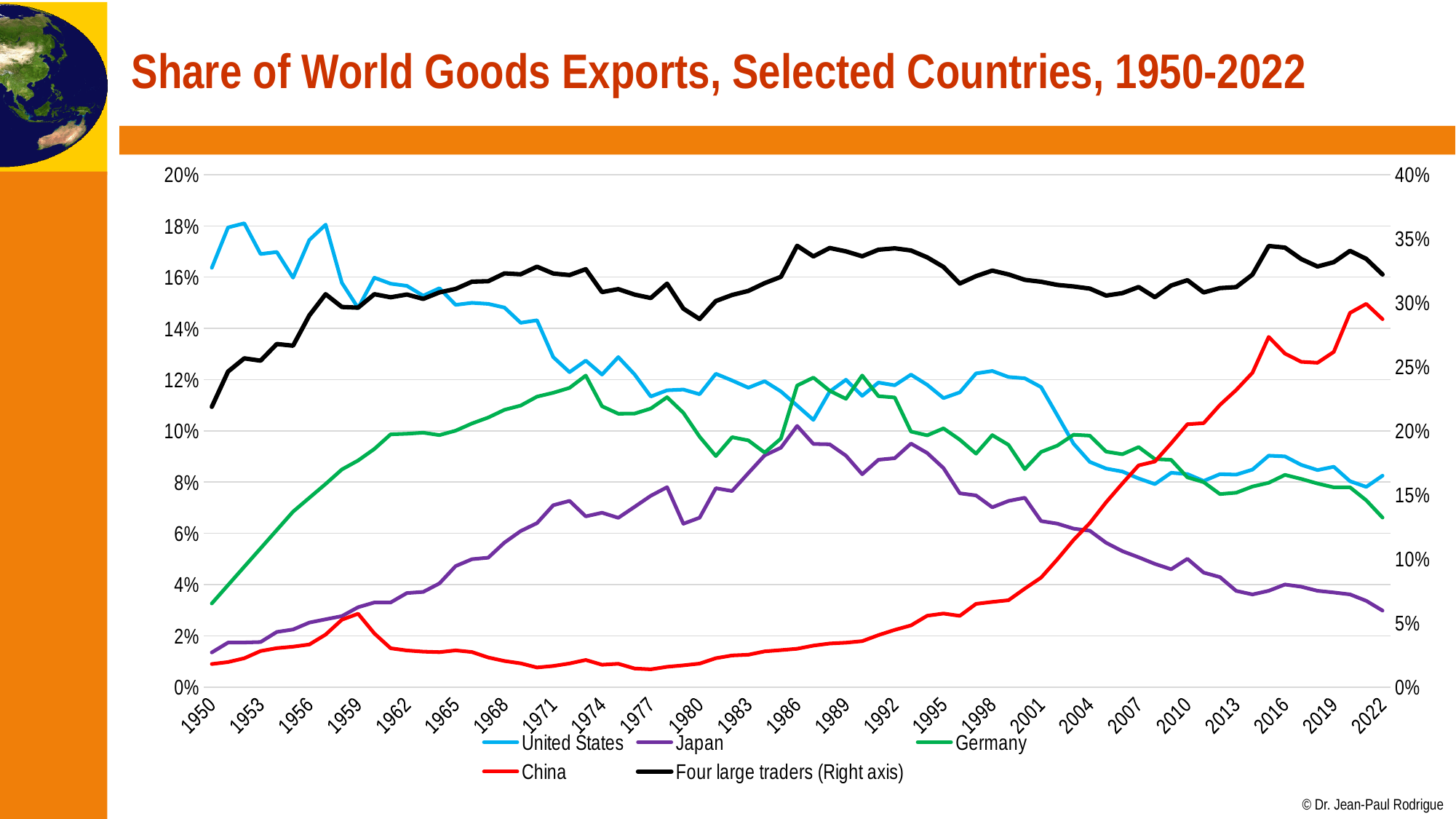
Among the four countries, which has the lowest share in 2022? Japan Is the value for the United States in 1950 greater or less than 14%? greater Does Japan's share rise or fall between 1995 and 2022? fall In 2022, which is larger, the share for China or the share for Germany? China What is the title of the chart? Share of World Goods Exports, Selected Countries, 1950-2022 How many series does the legend list? 5 Is the value for Japan in 2022 greater or less than 4%? less Is the value for China in 2022 greater or less than 12%? greater What kind of chart is shown on the slide? line chart Does China's share rise or fall between 2001 and 2016? rise Does Germany's share rise or fall between 1950 and 1962? rise Which series is plotted against the right axis? Four large traders